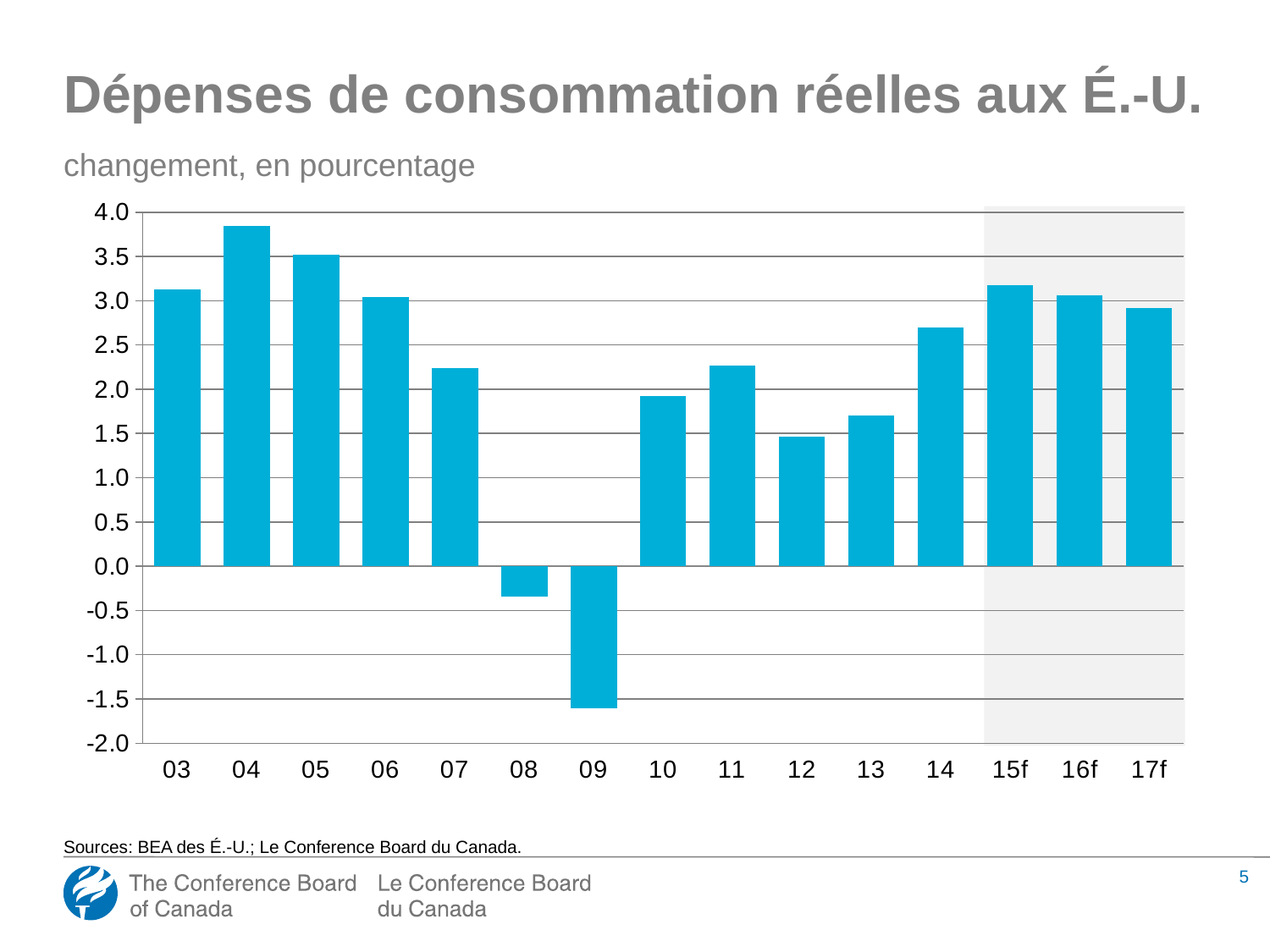
Which year has the highest value? 04 What kind of chart is shown on the slide? bar chart What is the title of the chart on the slide? Dépenses de consommation réelles aux É.-U. Do the values rise or fall from 12 to 15f? rise How many years (categories) are shown on the x axis? 15 How many years show a negative value? 2 Is the value for 04 greater or less than 3.5? greater Is the value for 09 greater or less than -1.0? less Which is larger, the value for 13 or the value for 12? 13 Is the value for 07 greater or less than 2.0? greater Which year has the lowest value? 09